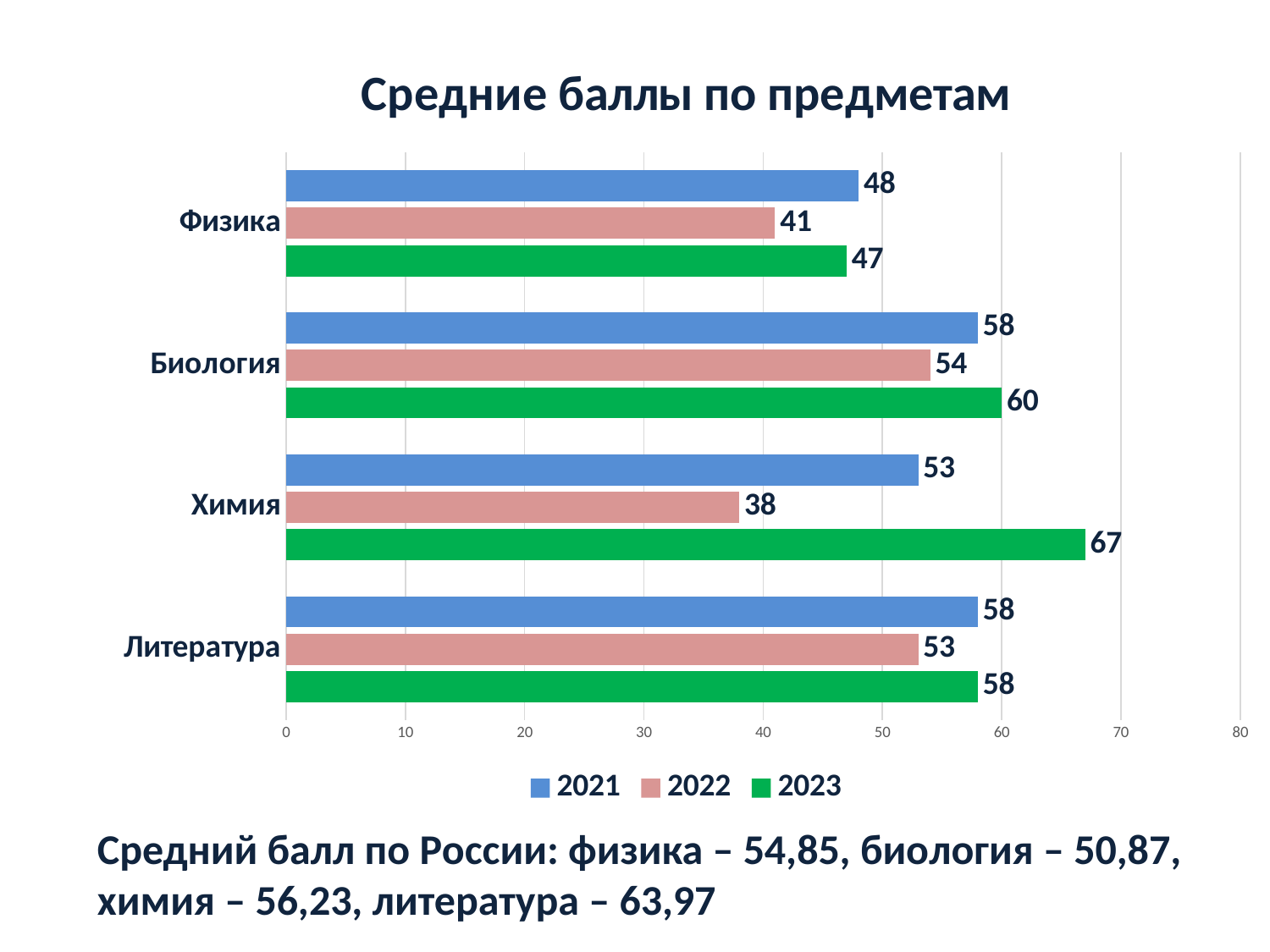
Which subject has the highest 2023 value? Химия How many series does the legend list? 3 What is the 2021 value for Биология? 58 What is the 2022 value for Физика? 41 What is the difference between the 2023 and 2022 values for Химия? 29 How many subjects are shown on the chart? 4 What is the 2023 value for Химия? 67 Which subject has the lowest 2022 value? Химия Which colour represents the 2023 series? green Which is larger for Физика: the 2021 value or the 2023 value? 2021 What is the title of the chart? Средние баллы по предметам What kind of chart is shown? bar chart